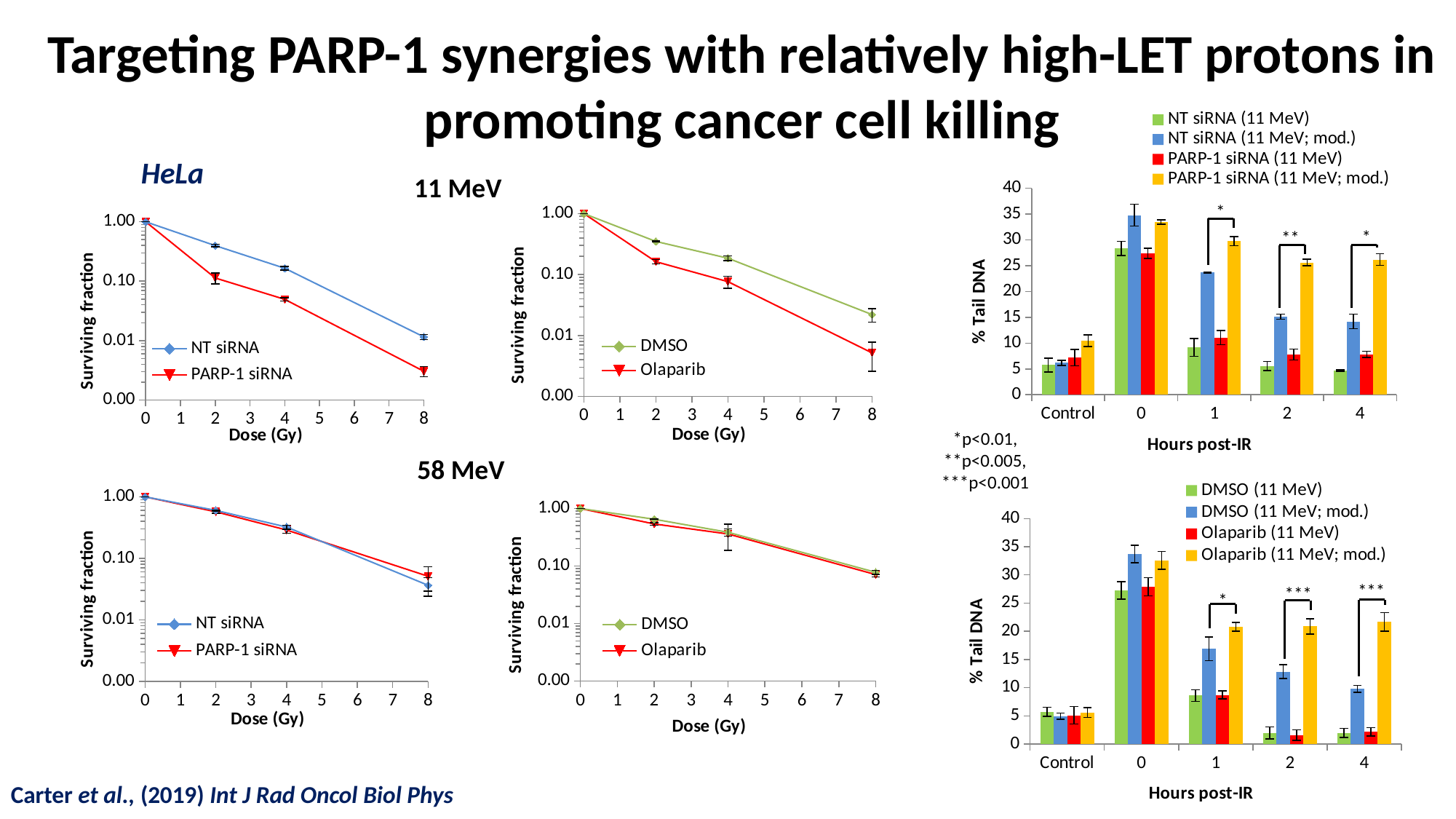
In the top-right bar chart, at 1 hour post-IR, which is larger: NT siRNA (11 MeV; mod.) or PARP-1 siRNA (11 MeV; mod.)? PARP-1 siRNA (11 MeV; mod.) In the top-left 11 MeV line chart, at 8 Gy, which series has the higher surviving fraction: NT siRNA or PARP-1 siRNA? NT siRNA In the top-left 11 MeV line chart, how many series does the legend list? 2 What is the x-axis label of the four line charts on the left and middle of the slide? Dose (Gy) In the top-left 11 MeV line chart, does the surviving fraction for NT siRNA rise or fall as the dose increases? fall In the top-right bar chart, is the value for PARP-1 siRNA (11 MeV) at 4 hours post-IR greater or less than 10? less In the top-right bar chart, is the value for NT siRNA (11 MeV; mod.) at 0 hours post-IR greater or less than 30? greater In the top-right bar chart, how many series does the legend list? 4 In the bottom-right bar chart, is the value for DMSO (11 MeV; mod.) at 2 hours post-IR greater or less than 10? greater What kind of chart is the top-right chart with the y axis '% Tail DNA'? bar chart What kind of chart is the top-left chart labelled 11 MeV with NT siRNA and PARP-1 siRNA? line chart In the bottom-right bar chart, how many categories are shown on the 'Hours post-IR' axis? 5